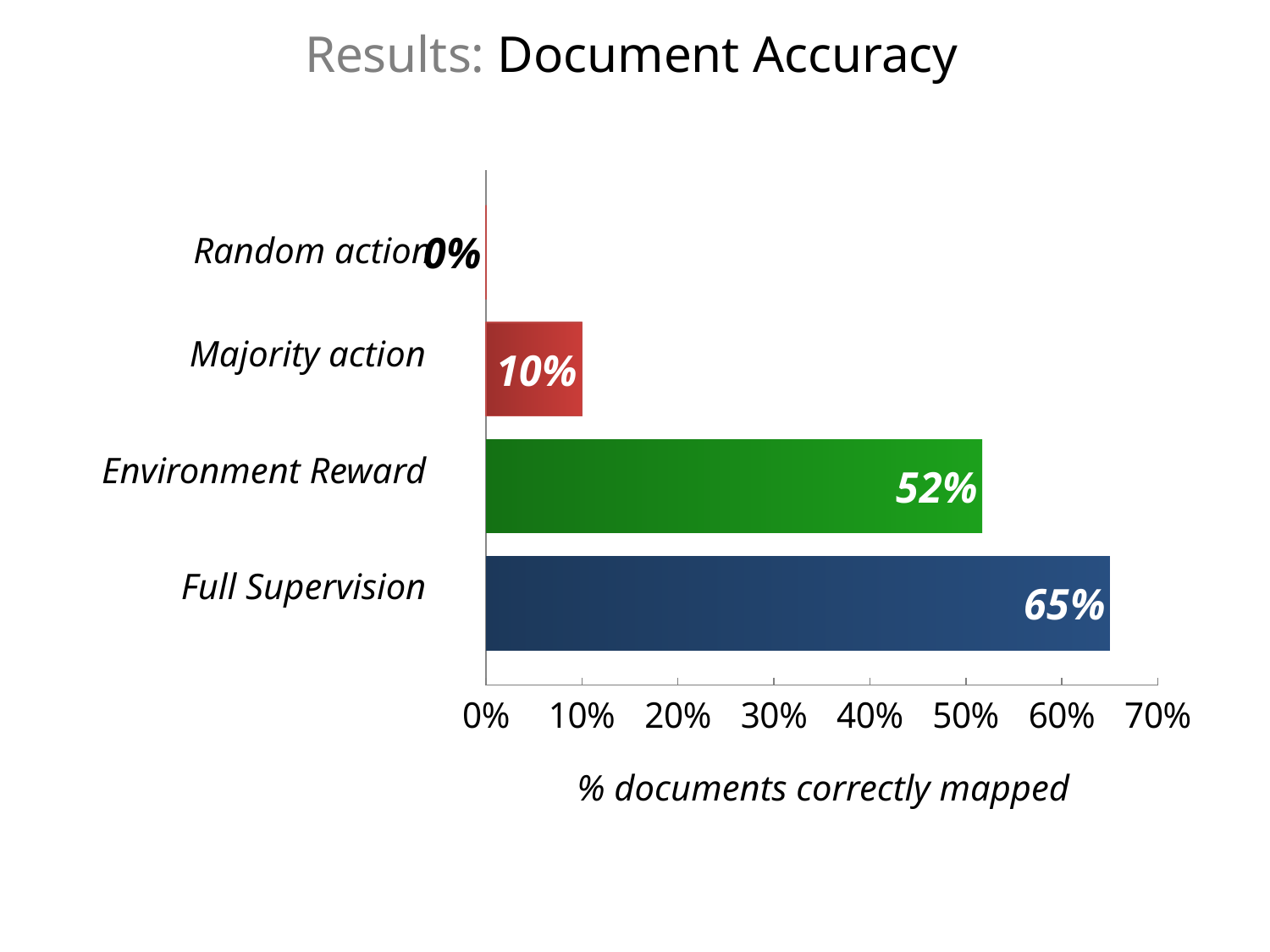
Which is larger, Environment Reward or Majority action? Environment Reward What is the value for Random action? 0% What is the x-axis label of the chart? % documents correctly mapped What kind of chart is this? Bar chart What is the difference between Full Supervision and Environment Reward? 13% Which category has the lowest value? Random action What is the value for Environment Reward? 52% Which category has the highest value? Full Supervision How many categories are shown in the chart? 4 What is the difference between Environment Reward and Majority action? 42% What is the value for Full Supervision? 65% What is the value for Majority action? 10%